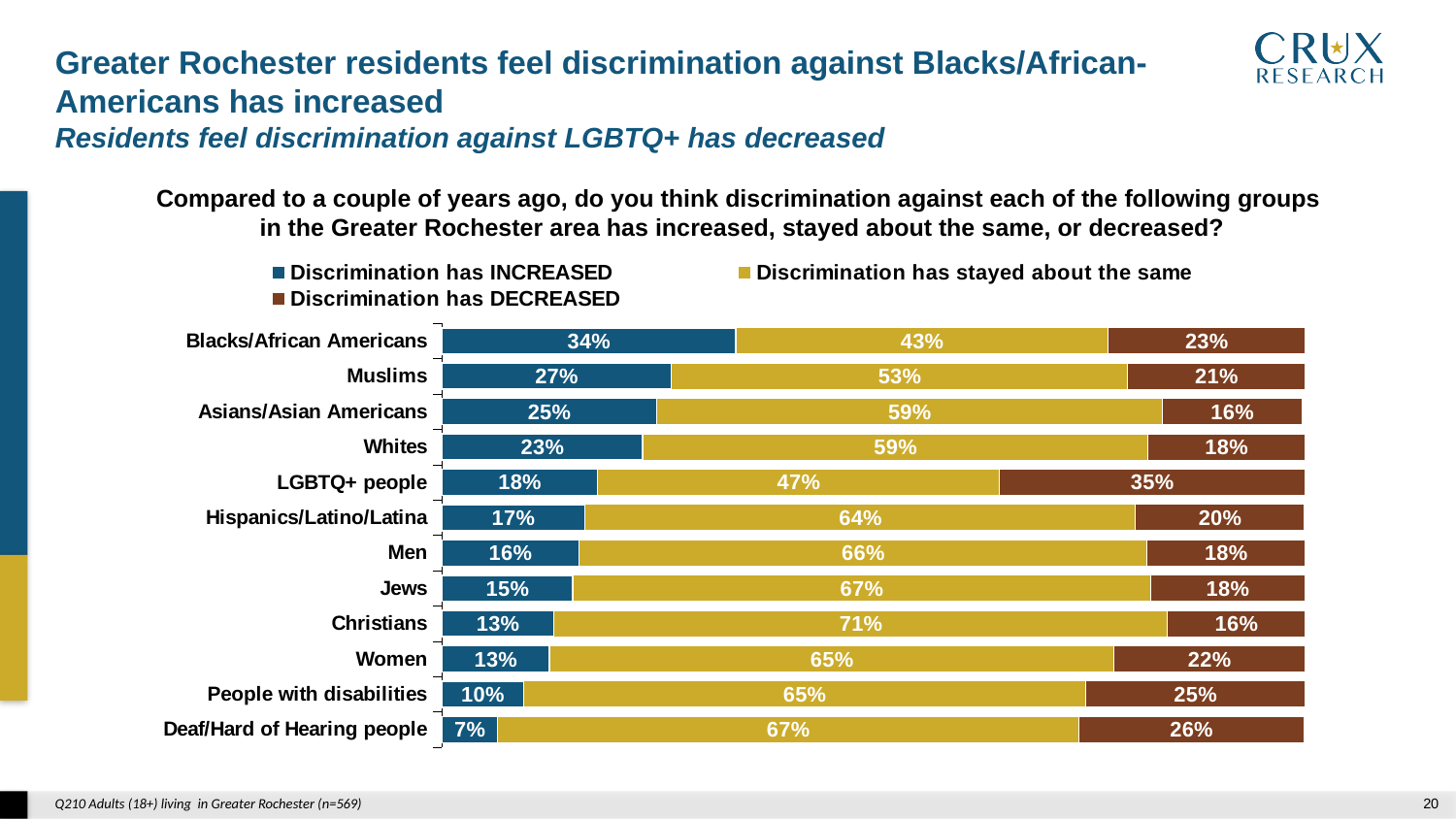
How many series does the legend list? 3 Which is larger: the 'decreased' percentage for Women or for Men? Women Which group has the highest share of residents saying discrimination has decreased? LGBTQ+ people What is the total of the three segments in the bar for Blacks/African Americans? 100% Which group has the lowest share of residents saying discrimination has increased? Deaf/Hard of Hearing people What percentage of residents say discrimination against Blacks/African Americans has increased? 34% What percentage of residents say discrimination against LGBTQ+ people has decreased? 35% What is the difference between the 'increased' percentages for Blacks/African Americans and Muslims? 7 percentage points What kind of chart is shown on the slide? Stacked bar chart How many groups are listed on the chart? 12 Which group has the highest share of residents saying discrimination has increased? Blacks/African Americans What percentage of residents say discrimination against Christians has stayed about the same? 71%